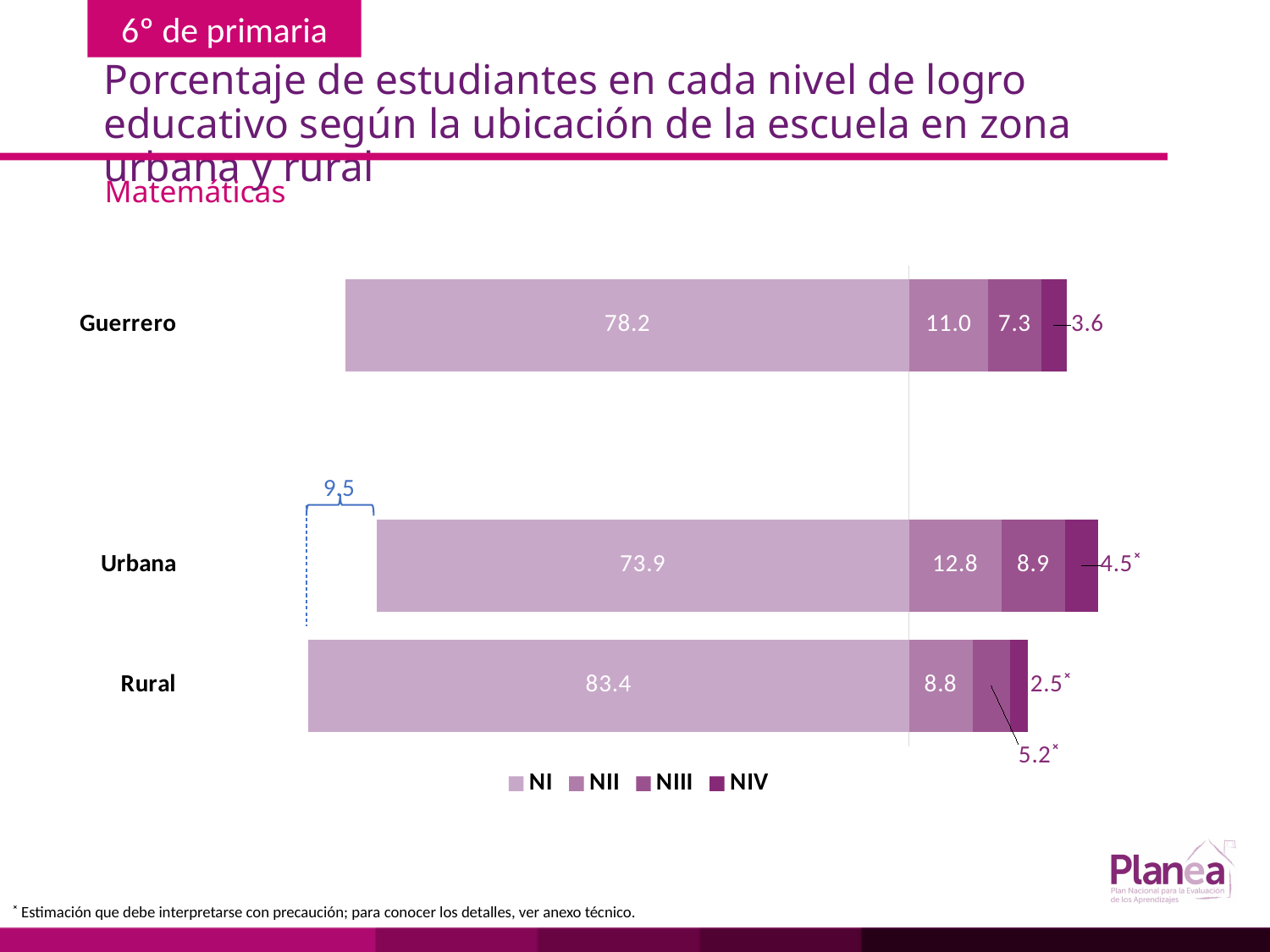
What is the NI value for Guerrero? 78.2 What is the NI value for Rural? 83.4 What is the NIII value for Urbana? 8.9 How many series does the legend list? 4 What is the difference between the NI values for Rural and Urbana? 9.5 How many categories are shown on the chart? 3 What is the NII value for Urbana? 12.8 Which is larger, the NII value for Guerrero or the NII value for Urbana? Urbana What kind of chart is shown on the slide? Stacked bar chart Which category has the highest NI value? Rural What is the NIV value for Guerrero? 3.6 Which category has the lowest NII value? Rural